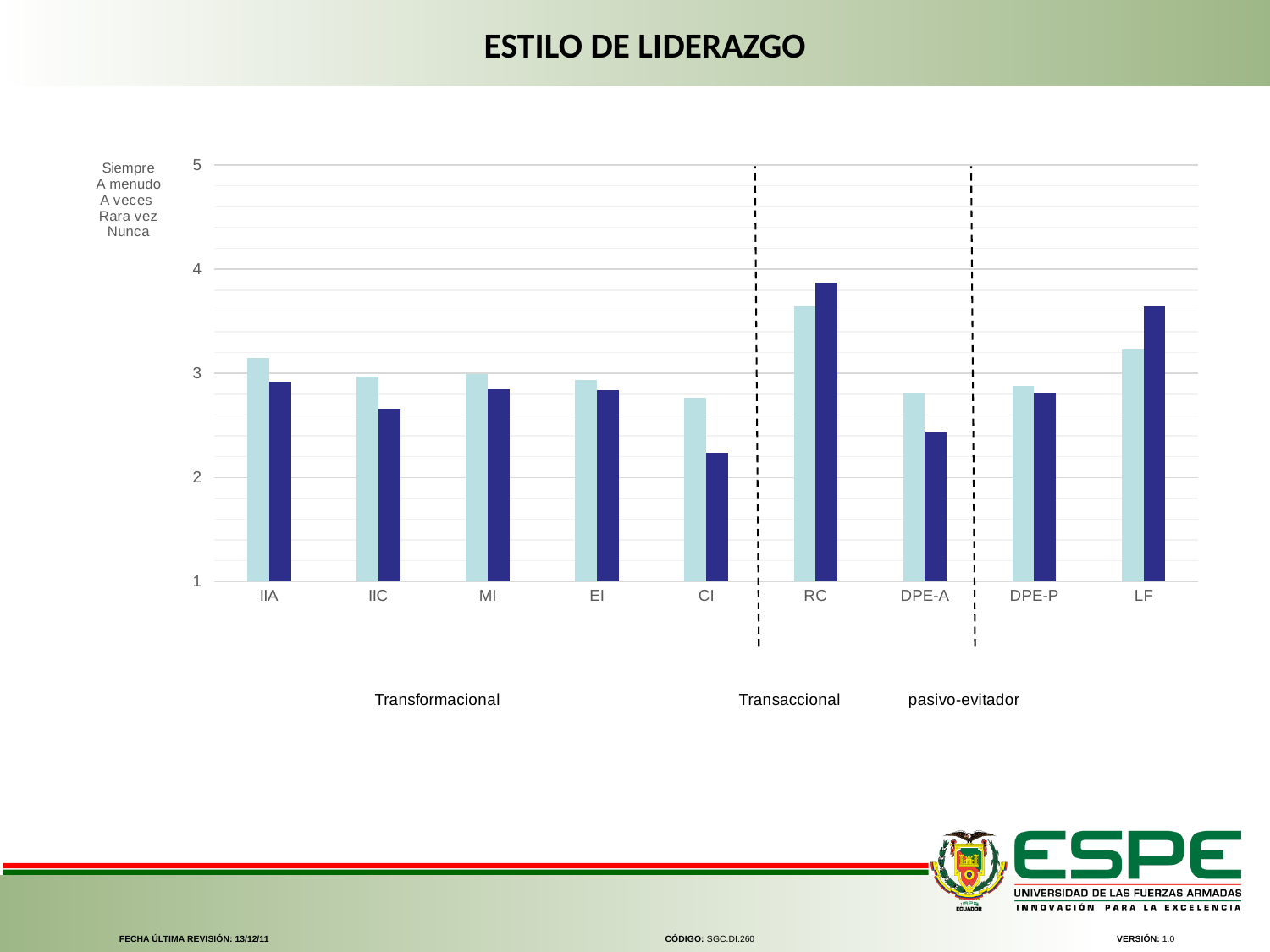
Is the dark blue bar for CI greater or less than 2? greater What is the title of the chart on the slide? ESTILO DE LIDERAZGO How many bars are plotted for each category in the chart? 2 For the category RC, which bar is taller, the light blue or the dark blue one? dark blue Is the light blue bar for IIA greater or less than 3? greater Which category has the shortest dark blue bar? CI Which category has the tallest dark blue bar? RC Which category has the tallest light blue bar? RC How many categories are shown along the x axis of the chart? 9 What kind of chart is shown on the slide? bar chart Is the dark blue bar for LF greater or less than 4? less For the category CI, which bar is taller, the light blue or the dark blue one? light blue